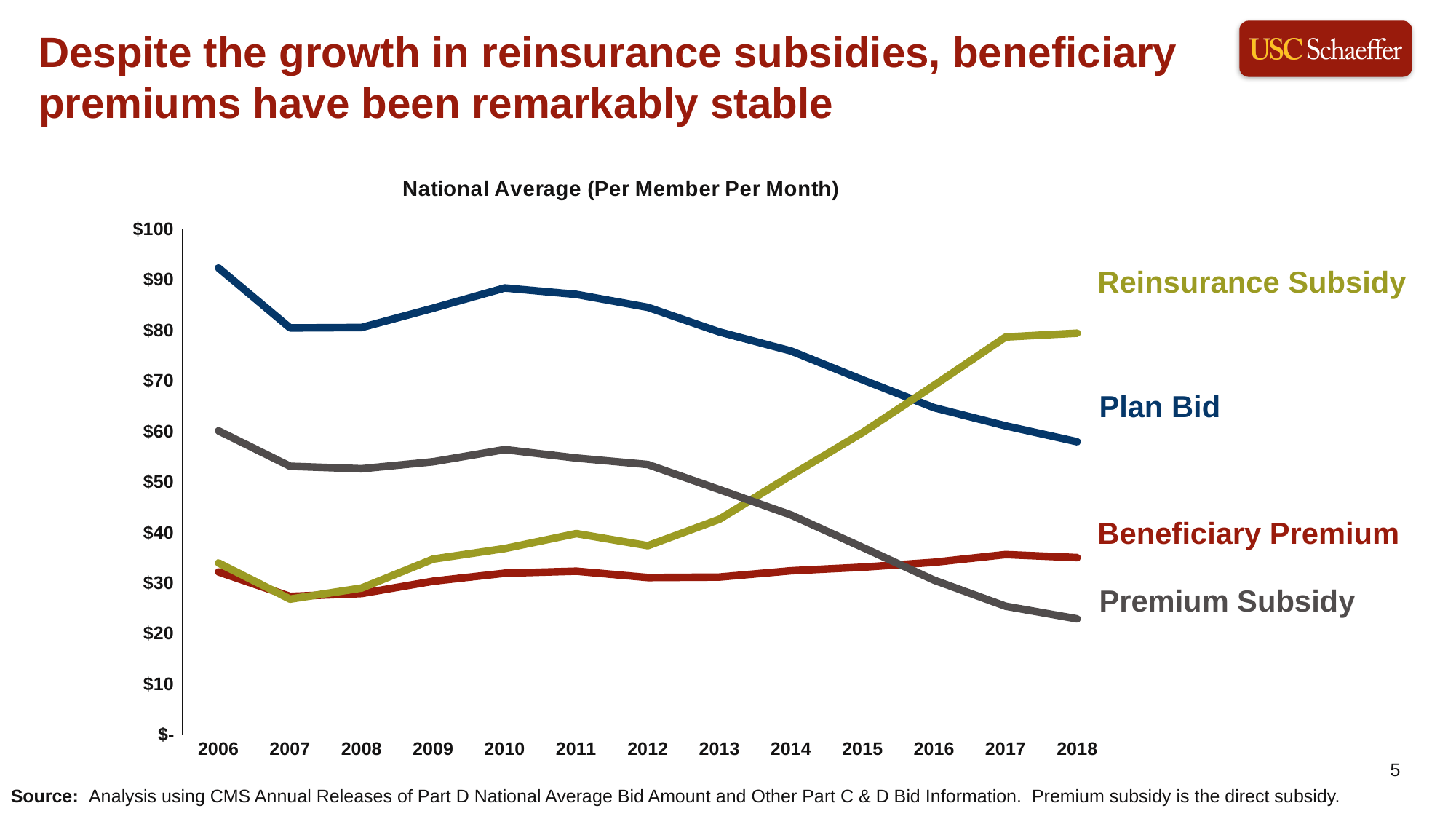
What kind of chart is shown on the slide? Line chart Is the value for Premium Subsidy in 2018 greater or less than $30? less Is the value for Plan Bid in 2006 greater or less than $80? greater Which series has the lowest value in 2018? Premium Subsidy In 2018, which is larger: the Reinsurance Subsidy or the Plan Bid? Reinsurance Subsidy What is the title of the chart? National Average (Per Member Per Month) How many years are shown along the x axis of the chart? 13 Which series has the highest value in 2018? Reinsurance Subsidy Does the Plan Bid line rise or fall between 2010 and 2018? Falls Does the Reinsurance Subsidy line rise or fall between 2012 and 2018? Rises How many series are plotted on the chart? 4 Which series has the highest value in 2006? Plan Bid